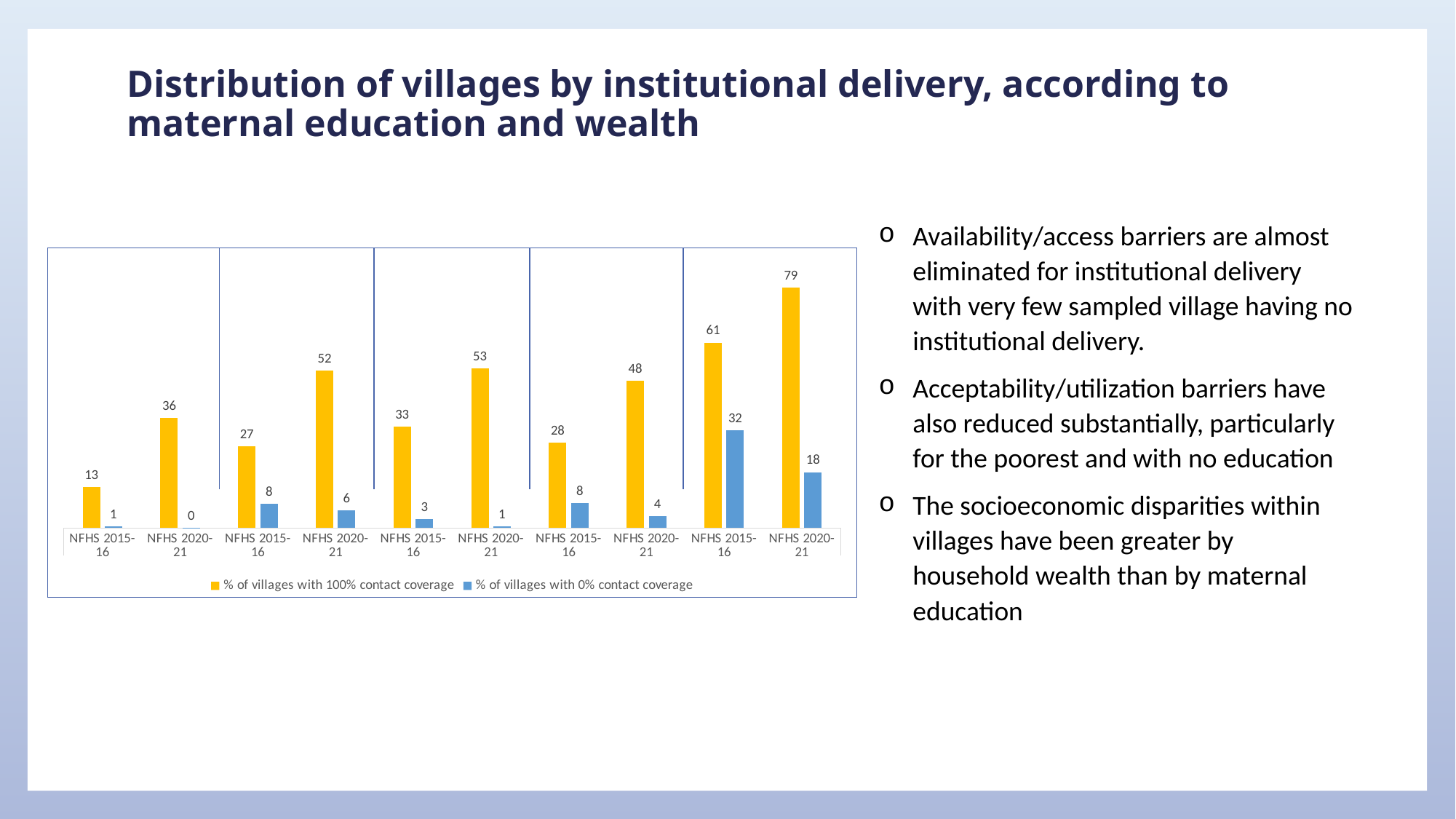
What is the highest value for '% of villages with 100% contact coverage' in the chart? 79 What is the value of '% of villages with 0% contact coverage' for the rightmost NFHS 2020-21 category? 18 What is the lowest value for '% of villages with 0% contact coverage' in the chart? 0 Which colour represents '% of villages with 0% contact coverage' in the chart? blue In the rightmost group, which is larger for NFHS 2015-16: '% of villages with 100% contact coverage' or '% of villages with 0% contact coverage'? % of villages with 100% contact coverage What is the difference between the '% of villages with 100% contact coverage' values for NFHS 2020-21 and NFHS 2015-16 in the leftmost group? 23 What is the difference between the '% of villages with 100% contact coverage' values for NFHS 2020-21 and NFHS 2015-16 in the rightmost group? 18 What kind of chart is shown on the slide? bar chart What is the value of '% of villages with 100% contact coverage' for the leftmost NFHS 2015-16 category? 13 How many category labels are shown along the x axis of the chart? 10 How many series does the chart legend list? 2 What is the value of '% of villages with 0% contact coverage' for the NFHS 2015-16 category in the rightmost group? 32